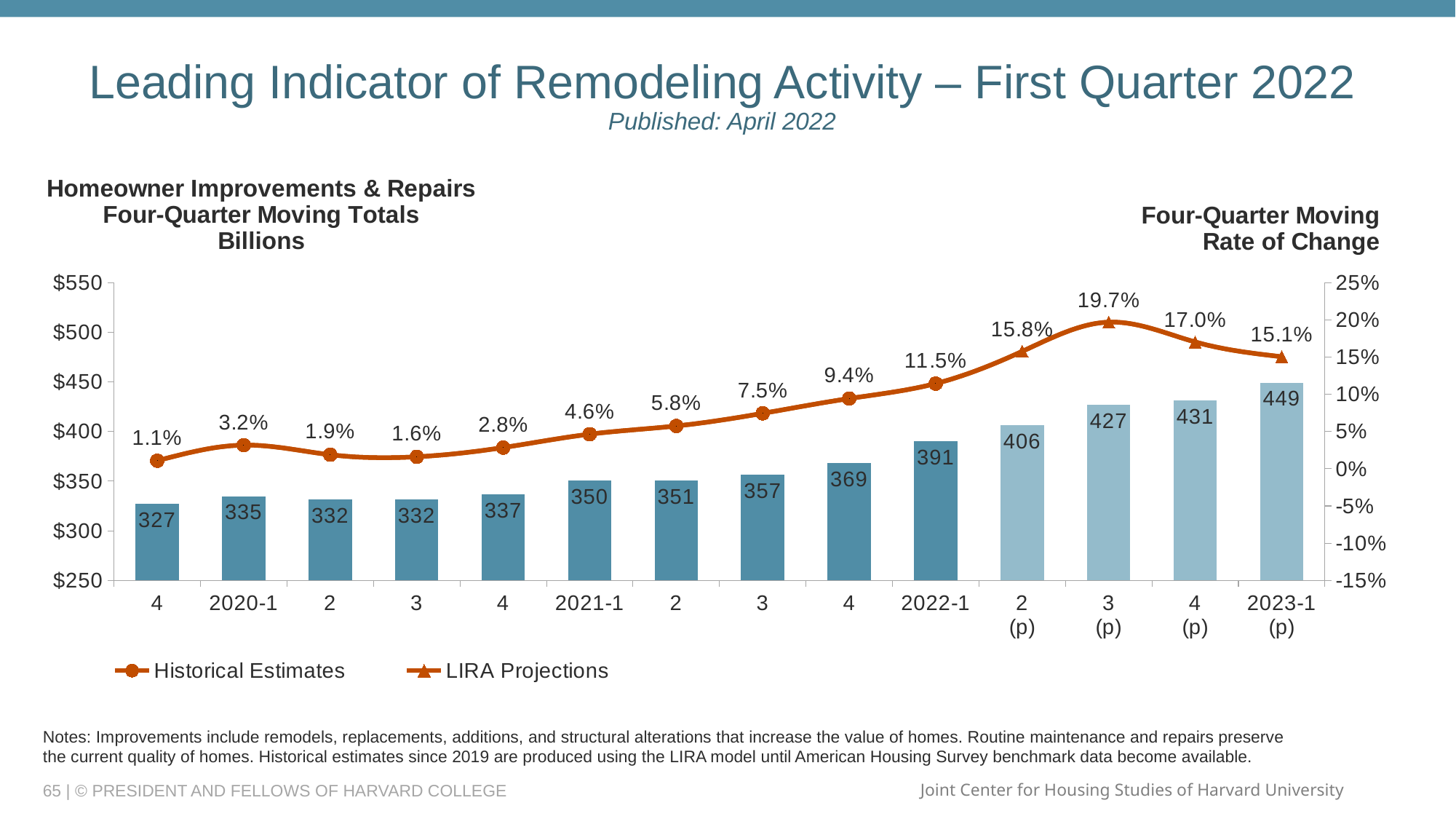
What is the four-quarter moving total (in billions) for 2022-1? 391 What is the projected four-quarter moving total for 2023-1 (p)? 449 Which is larger, the rate of change for 2022-1 or for 2 (p) of 2022? 2 (p) of 2022 What is the difference between the four-quarter moving totals for 2023-1 (p) and 2022-1? 58 How many quarters (bars) are shown on the chart? 14 Which quarter has the lowest four-quarter moving total? 4 (2019) Is the four-quarter moving total for 2021-1 greater or less than $400 billion? less What are the two series named in the legend? Historical Estimates and LIRA Projections How many series does the legend list? 2 What kind of chart is used to show the four-quarter moving totals in billions? bar chart Which quarter has the highest four-quarter moving rate of change? 3 (p) (2022) What is the four-quarter moving rate of change shown for 2021-1? 4.6%